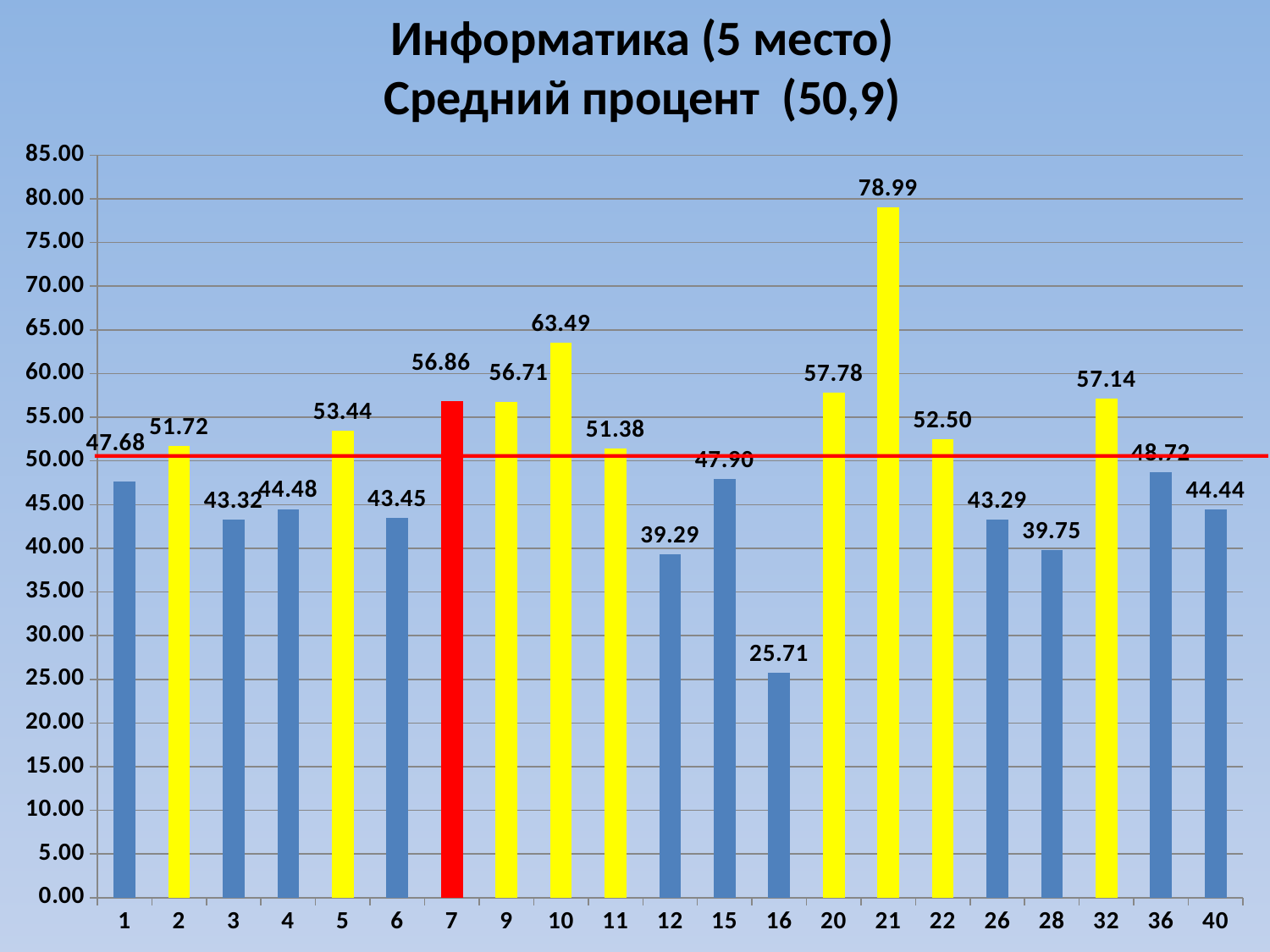
What is the value for category 21? 78.99 What is the value for category 7, the red bar? 56.86 Is the value for category 12 greater or less than 40.00? less What is the difference between the values for category 21 and category 16? 53.28 Which category has the highest value? 21 What kind of chart is shown on the slide? bar chart What is the value for category 16? 25.71 How many categories are shown on the x axis? 21 What is the difference between the values for category 10 and category 7? 6.63 Which is larger, the value for category 10 or the value for category 20? 10 Which category has the lowest value? 16 What is the title of the chart? Информатика (5 место) Средний процент (50,9)